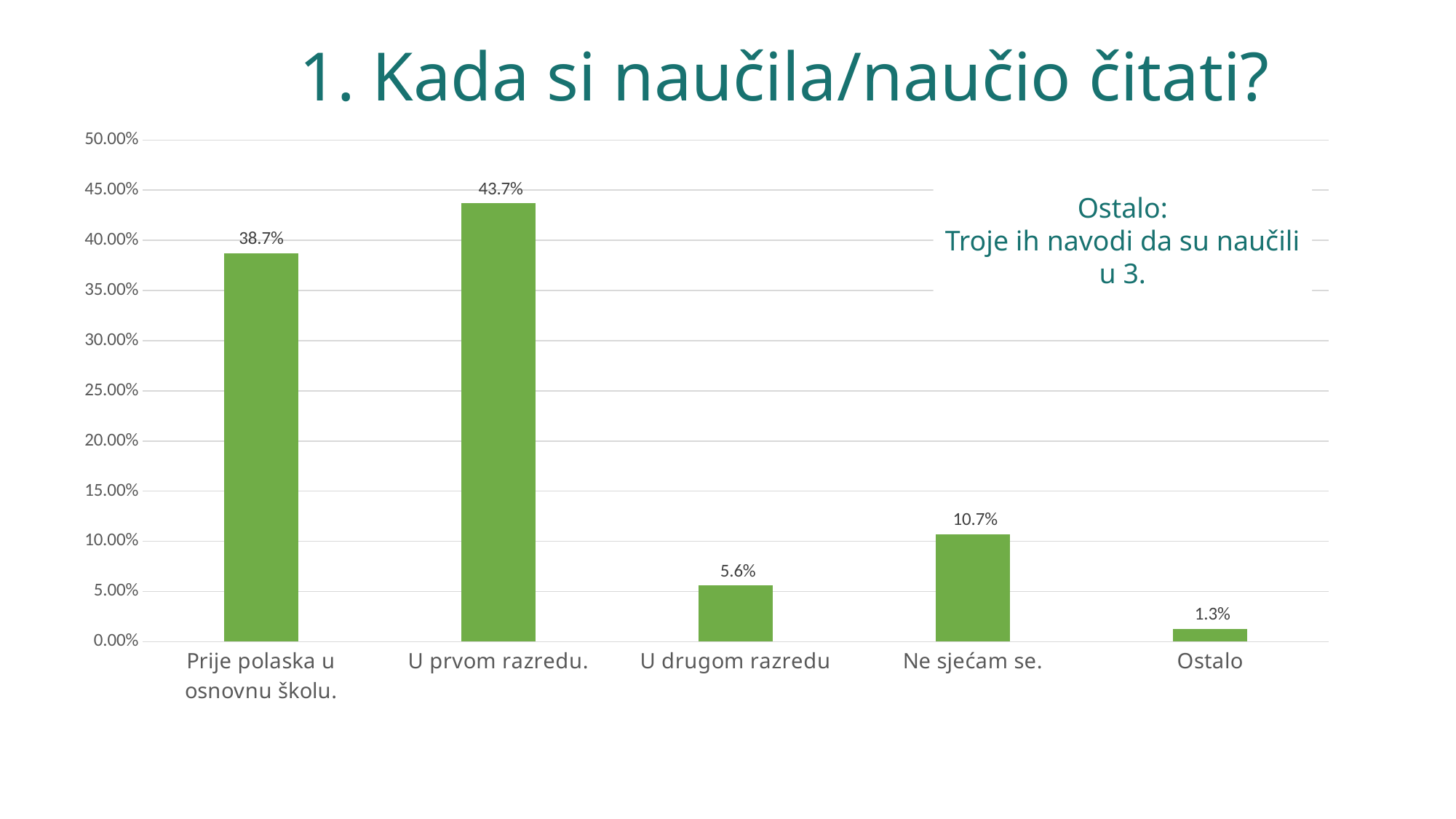
What is the value for "Ne sjećam se."? 10.7% What is the value for "Ostalo"? 1.3% Which is larger, the value for "U drugom razredu" or the value for "Ne sjećam se."? Ne sjećam se. What is the difference between the values for "U prvom razredu." and "Prije polaska u osnovnu školu."? 5.0% What is the value for "U prvom razredu."? 43.7% How many categories are shown on the x axis? 5 Which category has the lowest value? Ostalo Is the value for "U drugom razredu" greater or less than 10.00%? less What is the title of the slide? 1. Kada si naučila/naučio čitati? What kind of chart is shown on the slide? bar chart Which category has the highest value? U prvom razredu. What is the value for "Prije polaska u osnovnu školu."? 38.7%